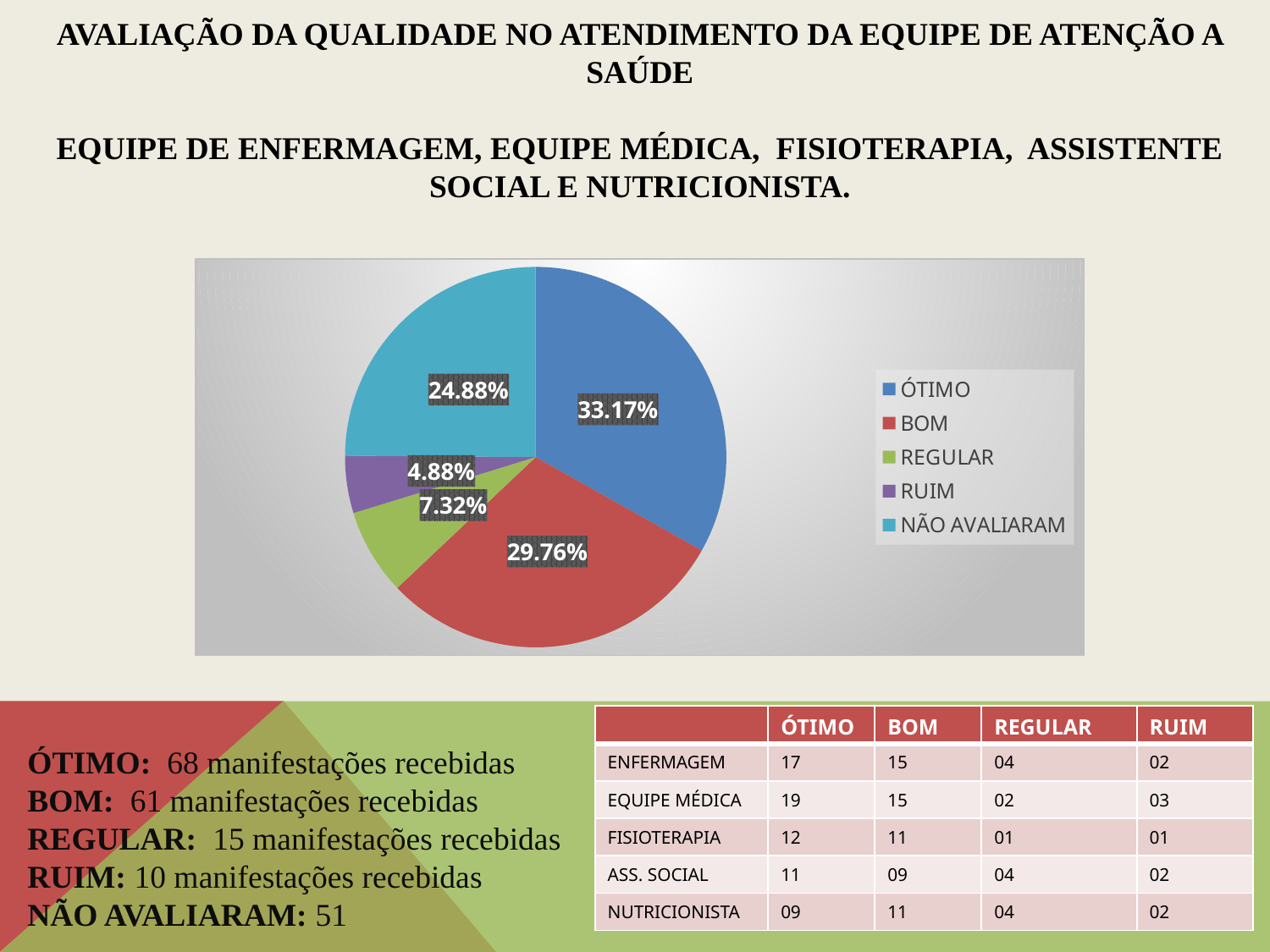
What percentage is shown for the NÃO AVALIARAM slice of the pie chart? 24.88% What percentage is shown for the BOM slice of the pie chart? 29.76% Which category has the largest slice in the pie chart? ÓTIMO What colour is the NÃO AVALIARAM slice in the pie chart? Light blue (teal) What percentage of the pie chart does the ÓTIMO slice represent? 33.17% Which slice is larger in the pie chart, REGULAR or RUIM? REGULAR What percentage is shown for the REGULAR slice of the pie chart? 7.32% Which category has the smallest slice in the pie chart? RUIM How many slices does the pie chart have? 5 What is the difference in percentage points between the ÓTIMO and BOM slices? 3.41 What type of chart is shown on the slide? Pie chart What percentage is shown for the RUIM slice of the pie chart? 4.88%